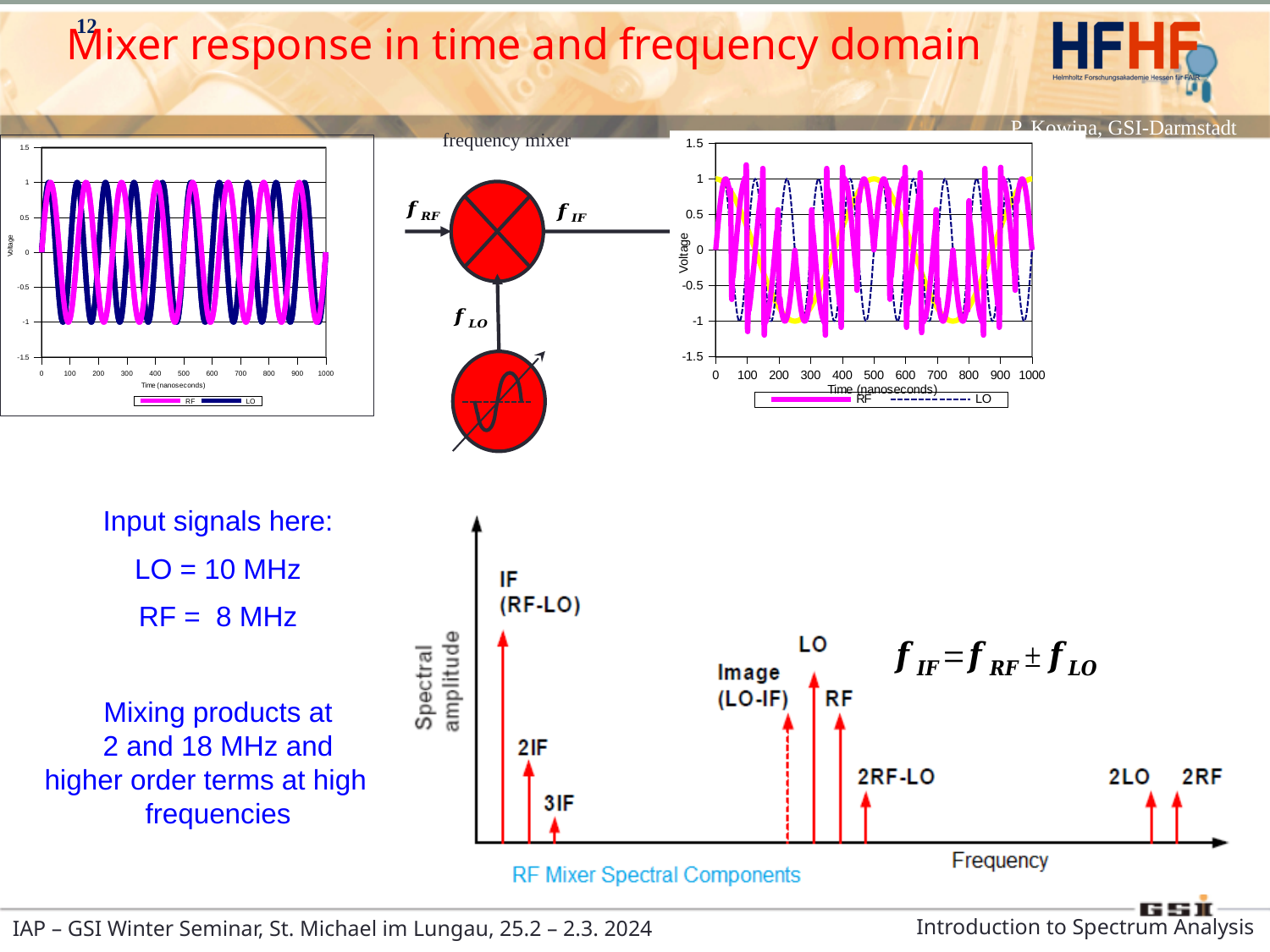
What kind of chart is the chart on the left of the slide? line chart In the left chart, is the minimum value of the LO series greater or less than -1.5? greater How many series does the legend of the left chart list? 2 In the right chart, which series is drawn as a dashed line? LO In the right chart, is the peak value of the RF series greater or less than 1.5? less What is the largest tick value shown on the x-axis of the left chart? 1000 What is the highest tick value shown on the y-axis of the right chart? 1.5 What kind of chart is the chart on the right of the slide (to the right of the mixer diagram)? line chart How many series does the legend of the right chart list? 2